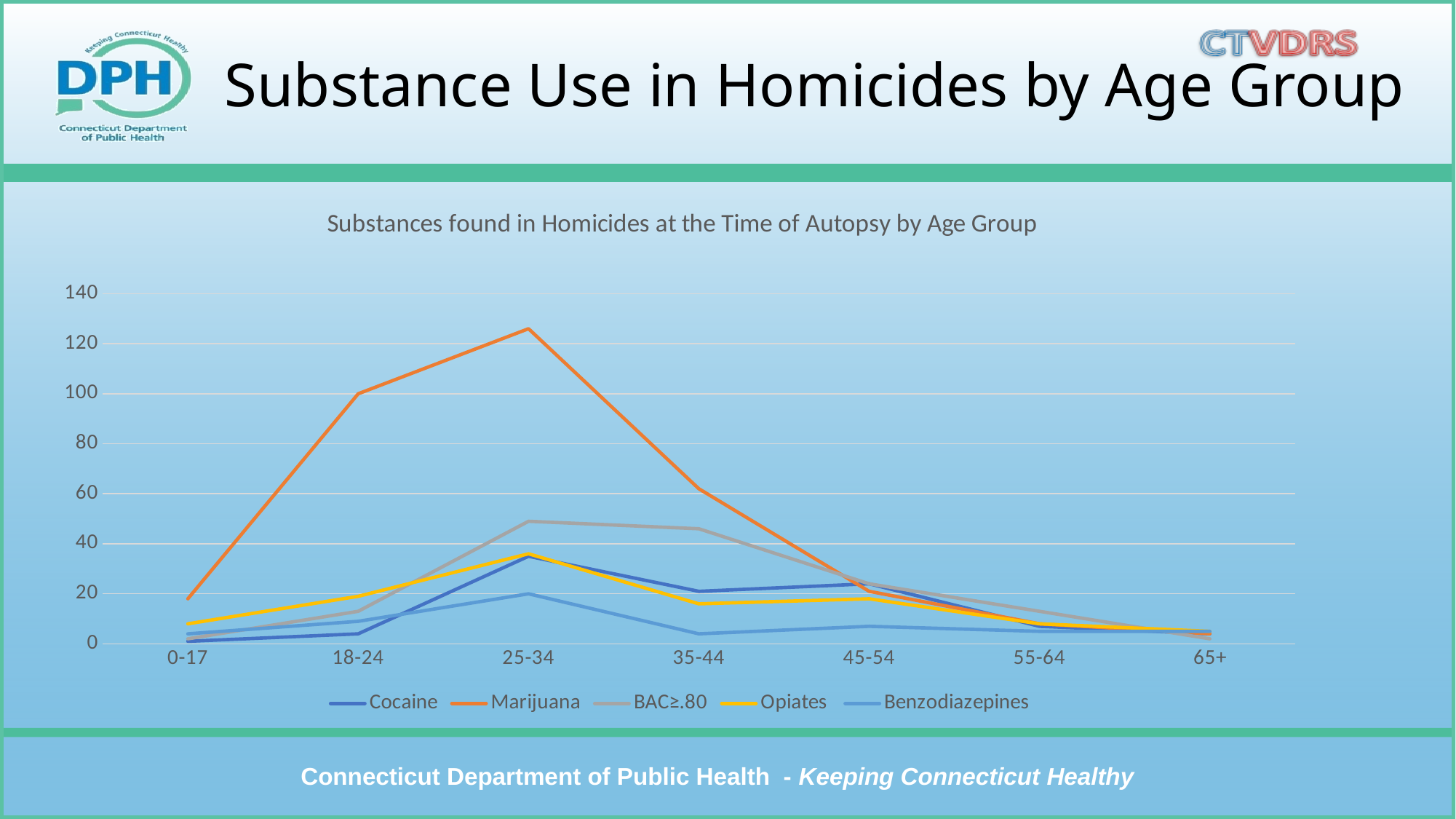
Which substance has the lowest value at the 25-34 age group? Benzodiazepines Which substance has the highest value at the 25-34 age group? Marijuana Is the value for Marijuana at 25-34 greater or less than 120? greater Which is larger at the 18-24 age group: Marijuana or BAC≥.80? Marijuana How many series does the legend list? 5 Does the Marijuana line rise or fall from 25-34 to 65+? fall What is the title of the chart? Substances found in Homicides at the Time of Autopsy by Age Group What kind of chart is shown on the slide? line chart How many age groups are shown on the x axis? 7 In which age group does the Marijuana line reach its highest value? 25-34 Is the value for BAC≥.80 at 25-34 greater or less than 40? greater Is the value for Marijuana at 35-44 greater or less than 80? less